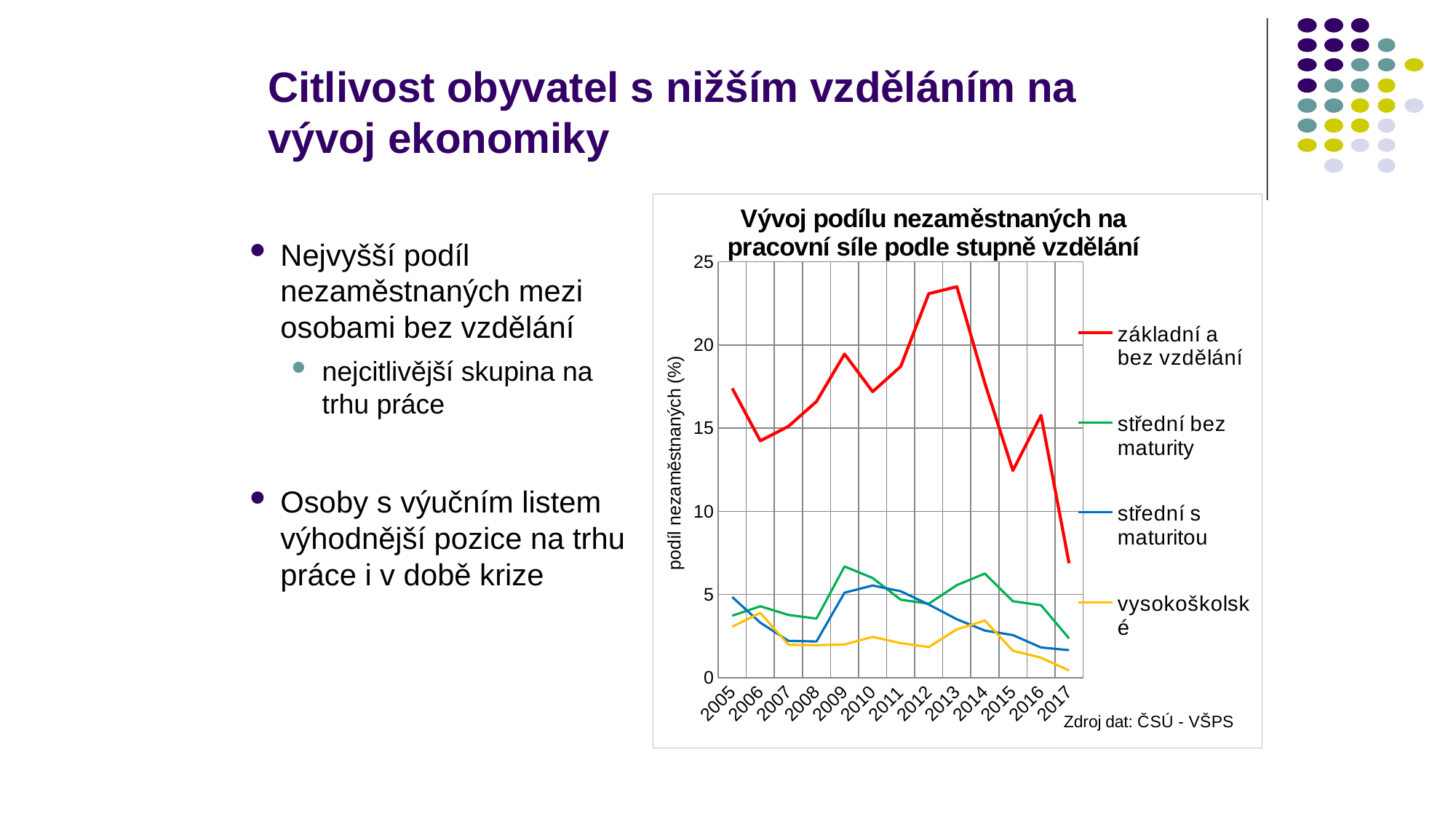
In 2009, which is larger: střední bez maturity or střední s maturitou? střední bez maturity Is the value for základní a bez vzdělání in 2017 greater or less than 10? less Is the value for střední bez maturity in 2009 greater or less than 5? greater Is the value for základní a bez vzdělání in 2013 greater or less than 20? greater What data source is cited below the chart? ČSÚ - VŠPS How many series does the legend of the chart list? 4 Does the value for základní a bez vzdělání rise or fall from 2013 to 2017? fall Which series has the highest values across the whole period in the chart? základní a bez vzdělání What is the label of the y axis of the chart? podíl nezaměstnaných (%) How many years are shown on the x axis of the chart? 13 Which series has the lowest value in 2017? vysokoškolské What kind of chart is shown on the slide? line chart